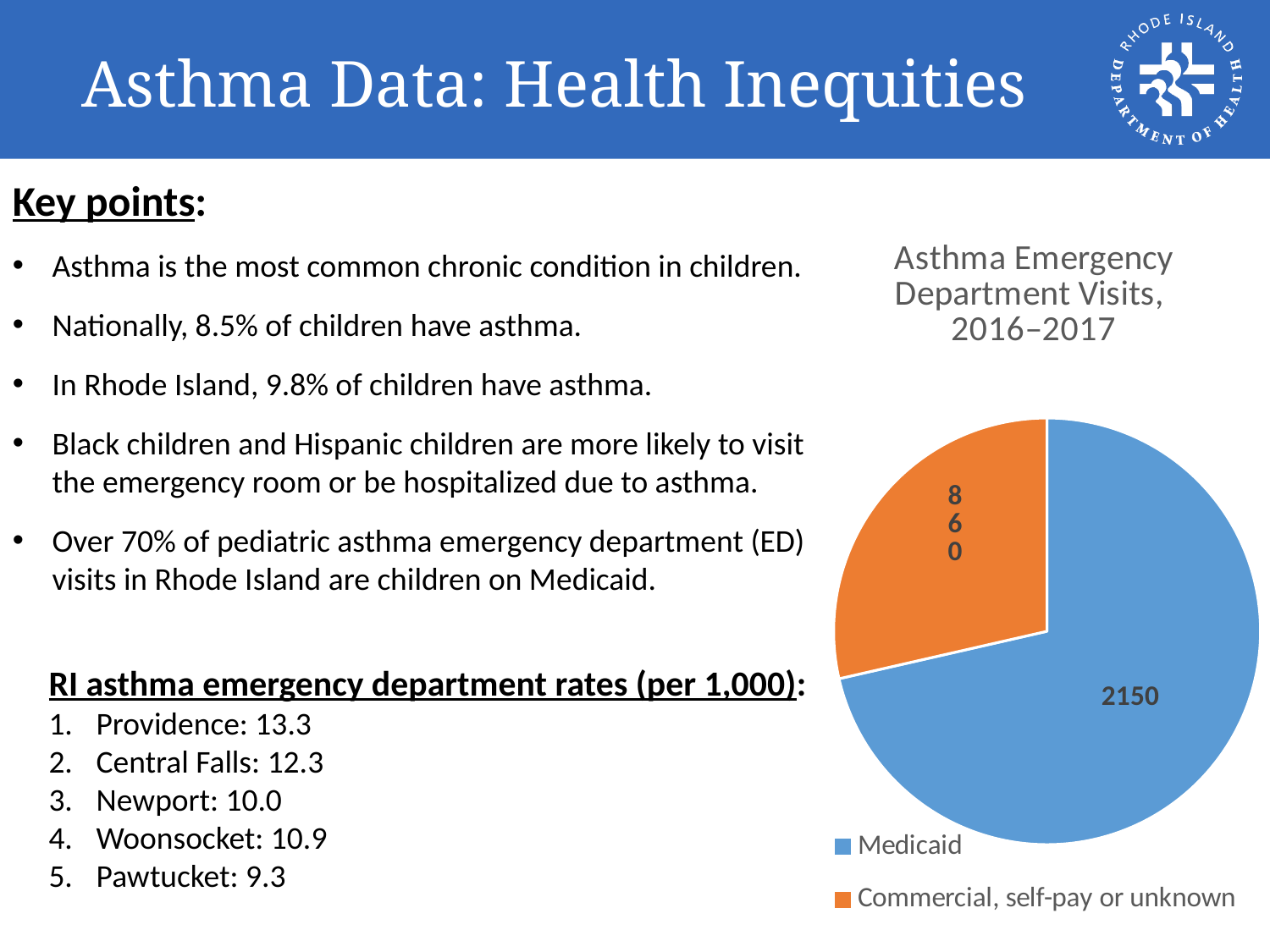
What is the total of all slices in the pie chart? 3010 What type of chart is shown on the slide? Pie chart What is the difference between the Medicaid value and the Commercial, self-pay or unknown value? 1290 What is the value for Commercial, self-pay or unknown in the pie chart? 860 Which category has the largest slice in the pie chart? Medicaid How many slices does the pie chart have? 2 Which is larger: the Medicaid slice or the Commercial, self-pay or unknown slice? Medicaid What is the title of the chart? Asthma Emergency Department Visits, 2016–2017 What is the value for Medicaid in the pie chart? 2150 What colour is the Medicaid slice in the pie chart? Blue How many entries does the chart's legend list? 2 Which category has the smallest slice in the pie chart? Commercial, self-pay or unknown